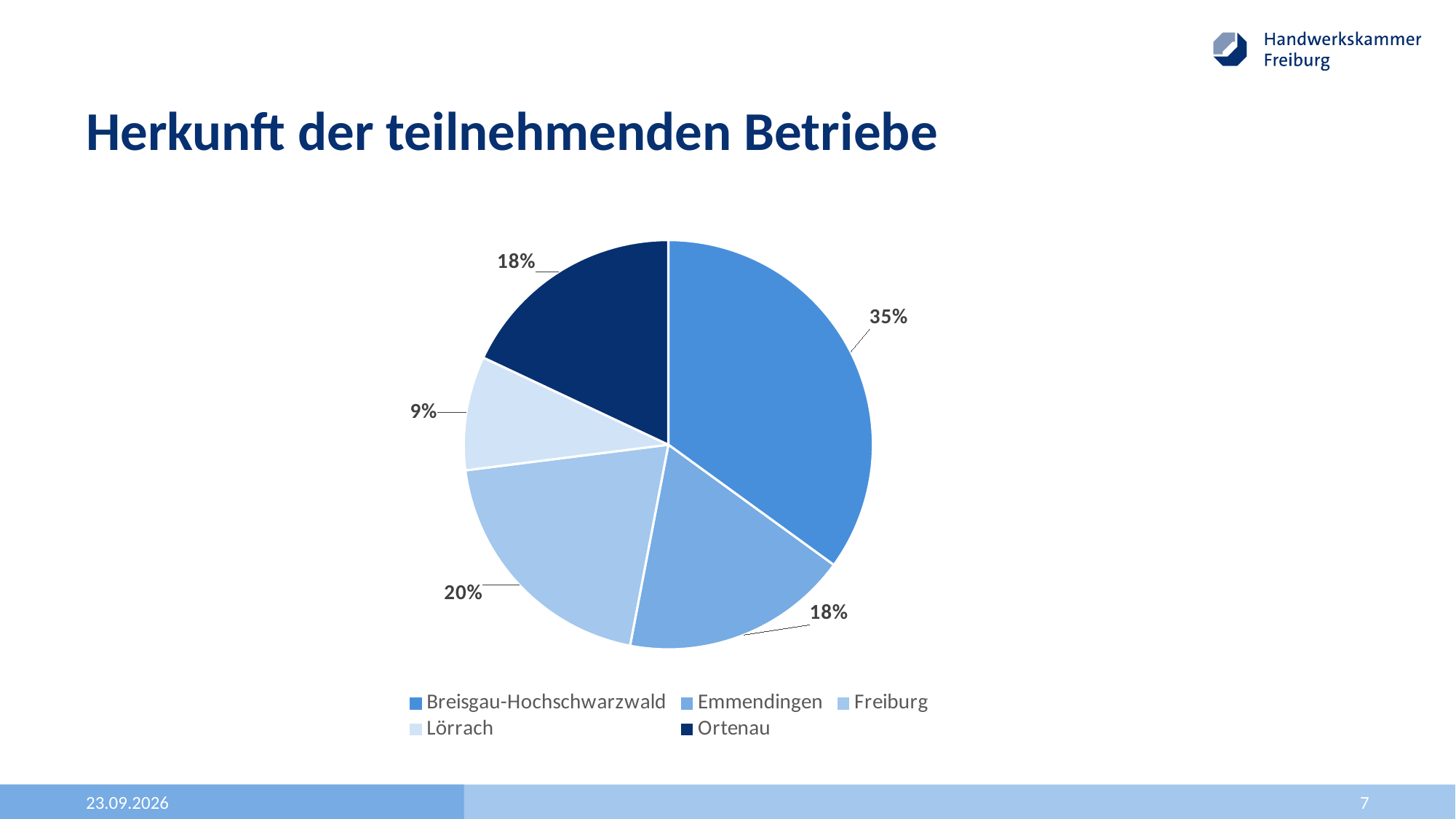
What share of the participating businesses comes from Breisgau-Hochschwarzwald? 35% What percentage is shown for Lörrach? 9% What share of the pie does Freiburg account for? 20% Which region has the smallest share of the pie? Lörrach Which has the larger share, Freiburg or Emmendingen? Freiburg What is the title of the slide containing the chart? Herkunft der teilnehmenden Betriebe How many percentage points larger is the share of Breisgau-Hochschwarzwald than that of Freiburg? 15 Which region has the largest share of the pie? Breisgau-Hochschwarzwald What type of chart is shown on the slide? pie chart What percentage is shown for Emmendingen? 18% How many regions are listed in the legend? 5 What percentage is shown for Ortenau? 18%